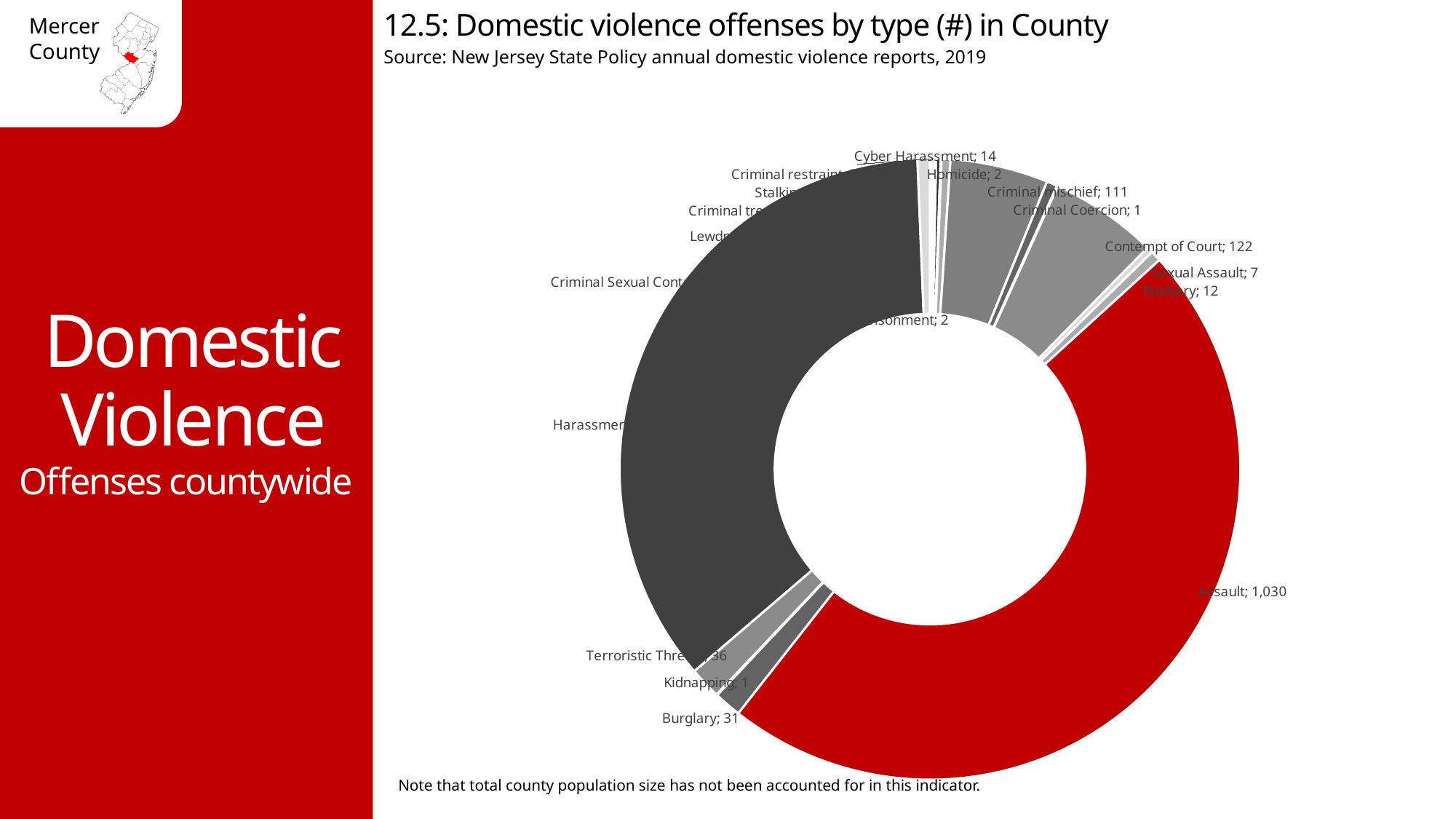
How many Robbery offenses does the chart show? 12 How many Contempt of Court offenses does the chart show? 122 Which is larger, Contempt of Court or Criminal Mischief? Contempt of Court What kind of chart is shown on the slide? Doughnut (pie) chart What is the value shown for Cyber Harassment? 14 What value is shown for Sexual Assault? 7 Which offense type has the largest slice of the chart? Assault What year of data does the chart's source line cite? 2019 What is the number of Assault offenses shown on the chart? 1,030 What value is shown for Criminal Mischief? 111 How many Burglary offenses are shown on the chart? 31 What is the difference between the Contempt of Court and Criminal Mischief values? 11